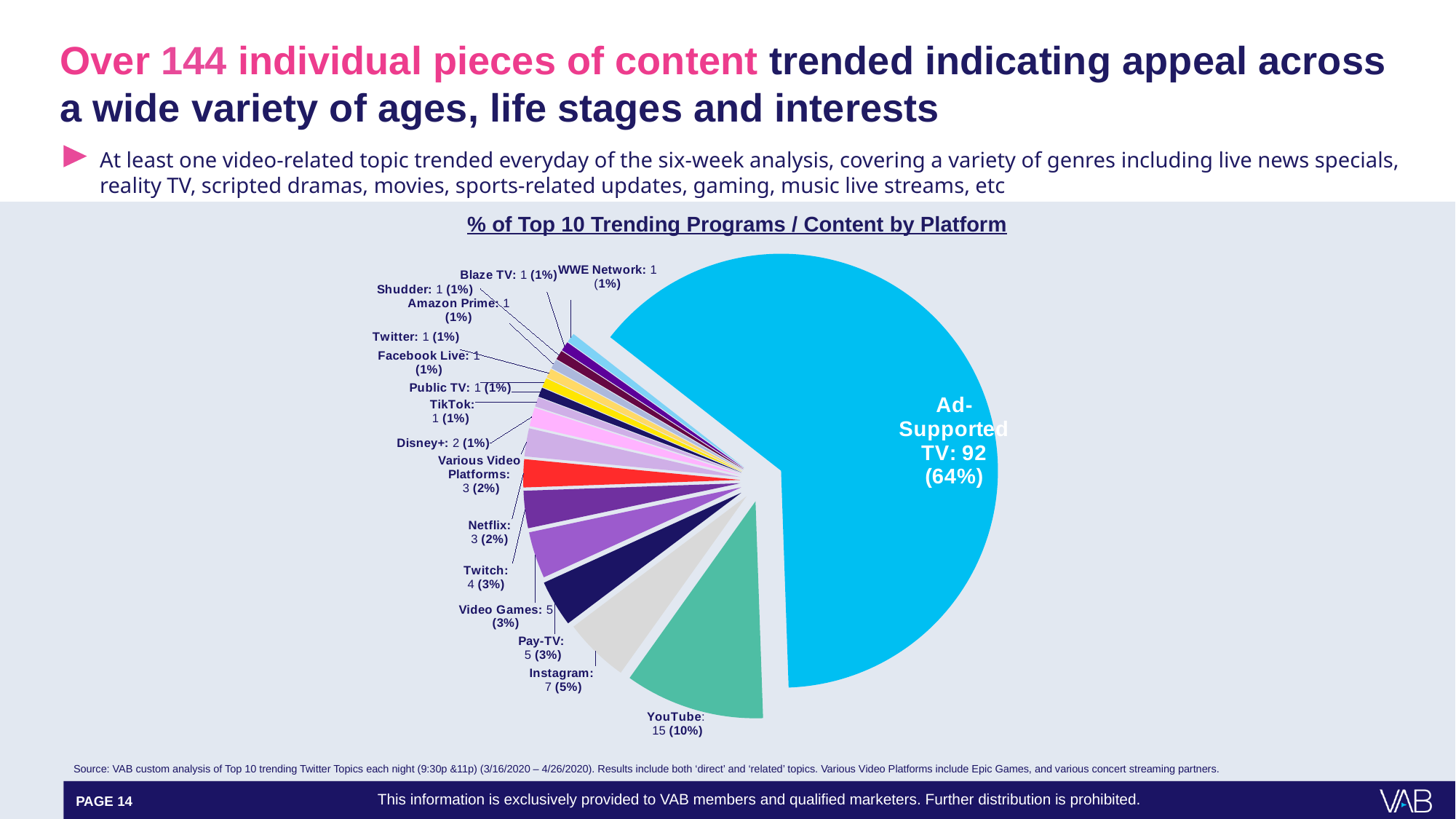
How many platform slices are shown in the pie chart? 17 Which is larger, the value for Instagram or the value for Pay-TV? Instagram What is the title of the chart? % of Top 10 Trending Programs / Content by Platform What kind of chart is shown on the slide? Pie chart What is the value for Twitch? 4 Which platform has the largest slice of the pie? Ad-Supported TV What is the difference between the Ad-Supported TV count and the YouTube count? 77 How many trending programs are attributed to YouTube? 15 What share of the pie does Ad-Supported TV account for? 64% What share of the pie does YouTube represent? 10% What is the value for Instagram? 7 What share of the pie does Netflix represent? 2%